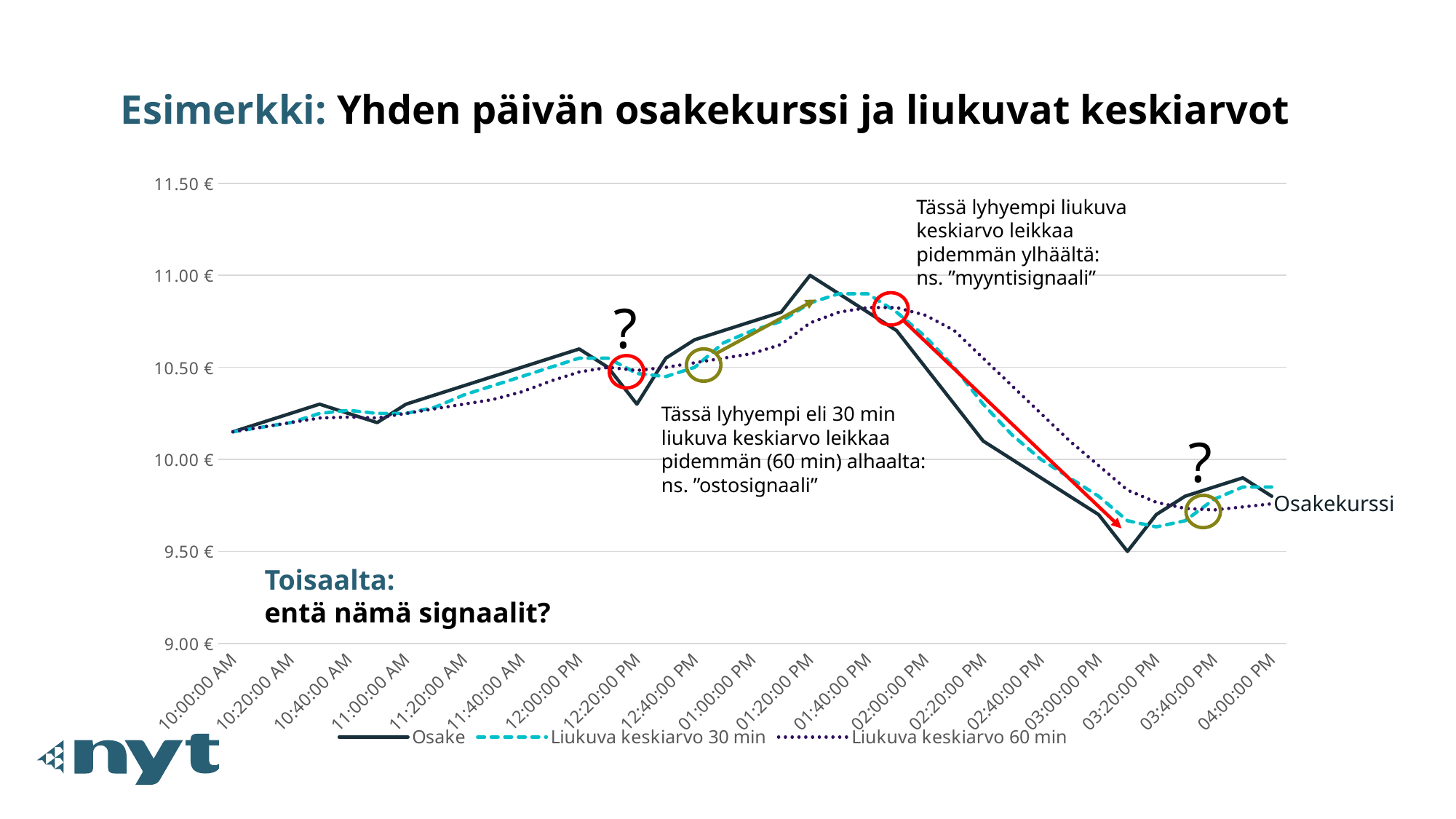
At which time does the Osake line reach its highest value? 01:20:00 PM What is the title of the slide? Esimerkki: Yhden päivän osakekurssi ja liukuvat keskiarvot What kind of chart is shown on the slide? line chart Is the Osake value at 02:20:00 PM greater or less than 10.00 €? greater At 02:40:00 PM, which is higher: the Osake line or the Liukuva keskiarvo 60 min line? Liukuva keskiarvo 60 min How many series does the legend list? 3 Between 01:20:00 PM and 03:20:00 PM, does the Osake line rise or fall? fall Is the Osake value at 03:00:00 PM greater or less than 10.00 €? less What are the three series named in the legend? Osake, Liukuva keskiarvo 30 min, Liukuva keskiarvo 60 min Is the Osake value at 12:20:00 PM greater or less than 10.50 €? less How many time labels are shown on the x axis? 19